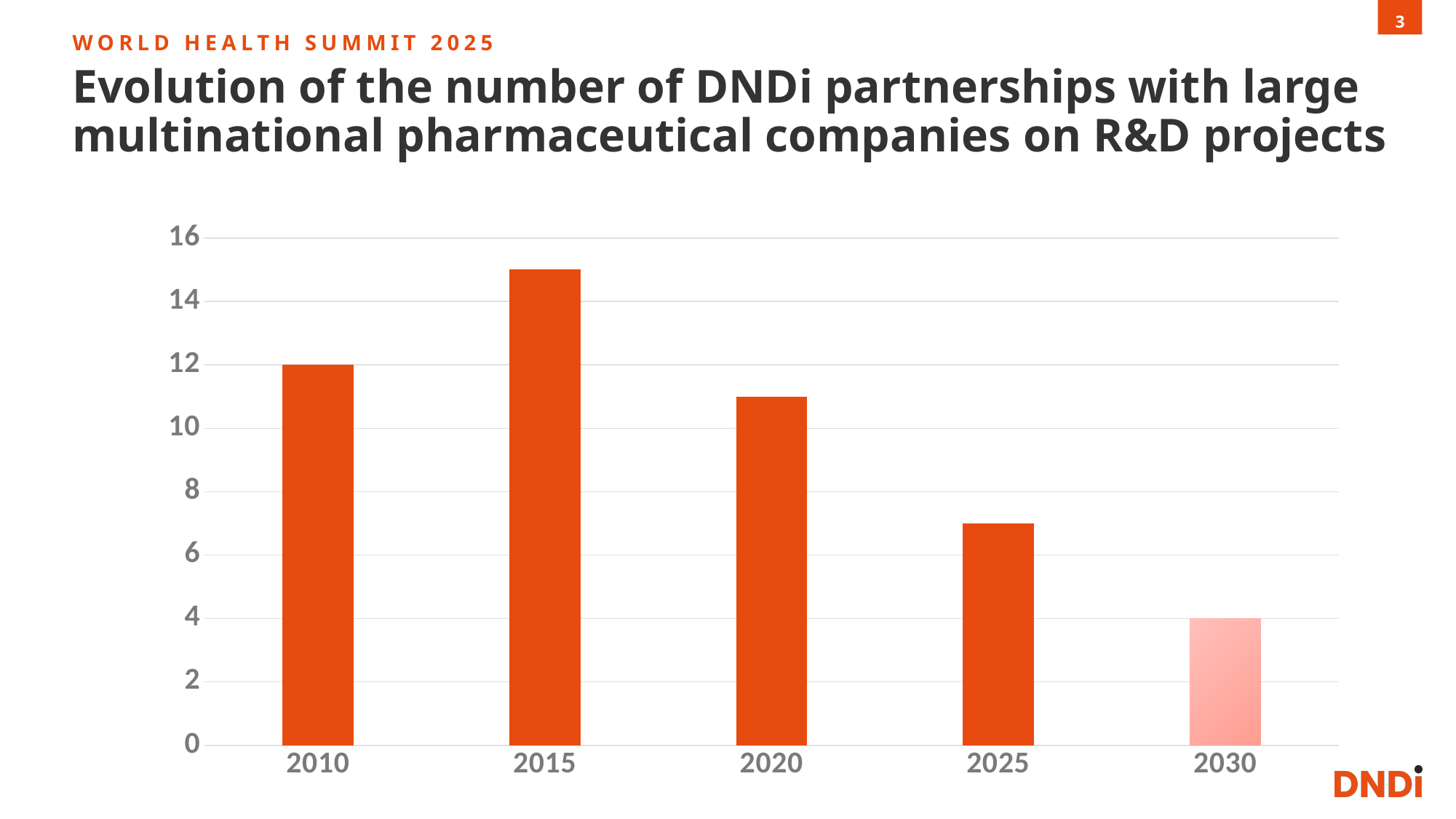
What type of chart is shown on the slide? bar chart Is the value for 2020 greater or less than 10? greater Is the value for 2015 greater or less than 14? greater From 2015 to 2030, do the values rise or fall along the x axis? fall What is the number of DNDi partnerships shown for 2030? 4 Which is larger, the value for 2015 or the value for 2025? 2015 What is the difference between the values for 2010 and 2030? 8 What is the number of DNDi partnerships shown for 2010? 12 How many years are shown on the x axis of the chart? 5 Which year has the highest number of partnerships? 2015 Is the value for 2025 greater or less than 8? less Which year has the lowest number of partnerships? 2030